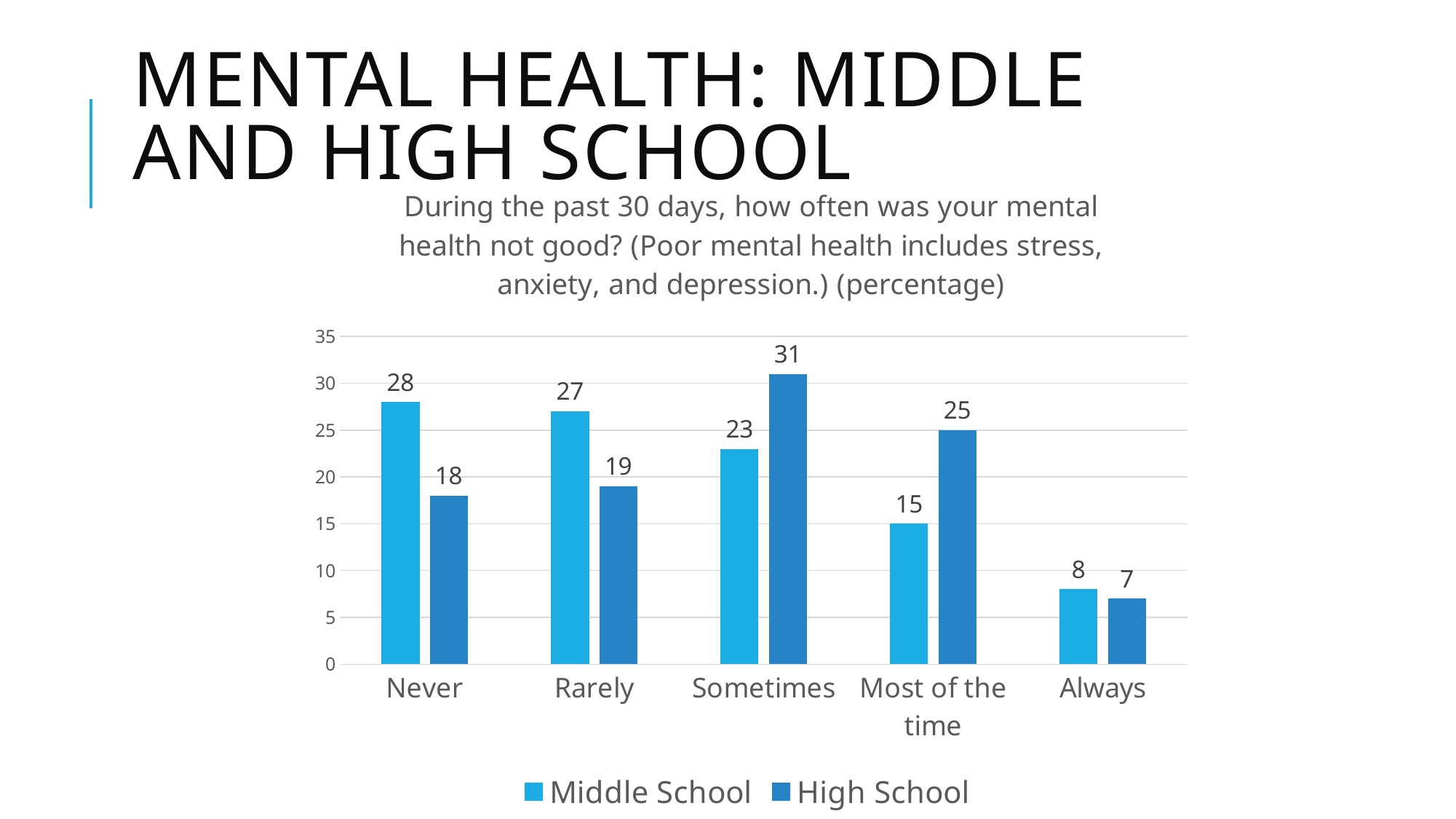
What is the High School value for "Sometimes"? 31 For "Rarely", which is larger: the Middle School value or the High School value? Middle School What are the two series named in the legend? Middle School and High School Which category has the highest High School value? Sometimes What is the High School value for "Most of the time"? 25 How many categories are shown on the x axis? 5 What is the difference between the High School and Middle School values for "Most of the time"? 10 What is the difference between the Middle School and High School values for "Never"? 10 Which category has the lowest Middle School value? Always How many series does the legend list? 2 What kind of chart is shown on the slide? Bar chart What is the Middle School value for "Never"? 28